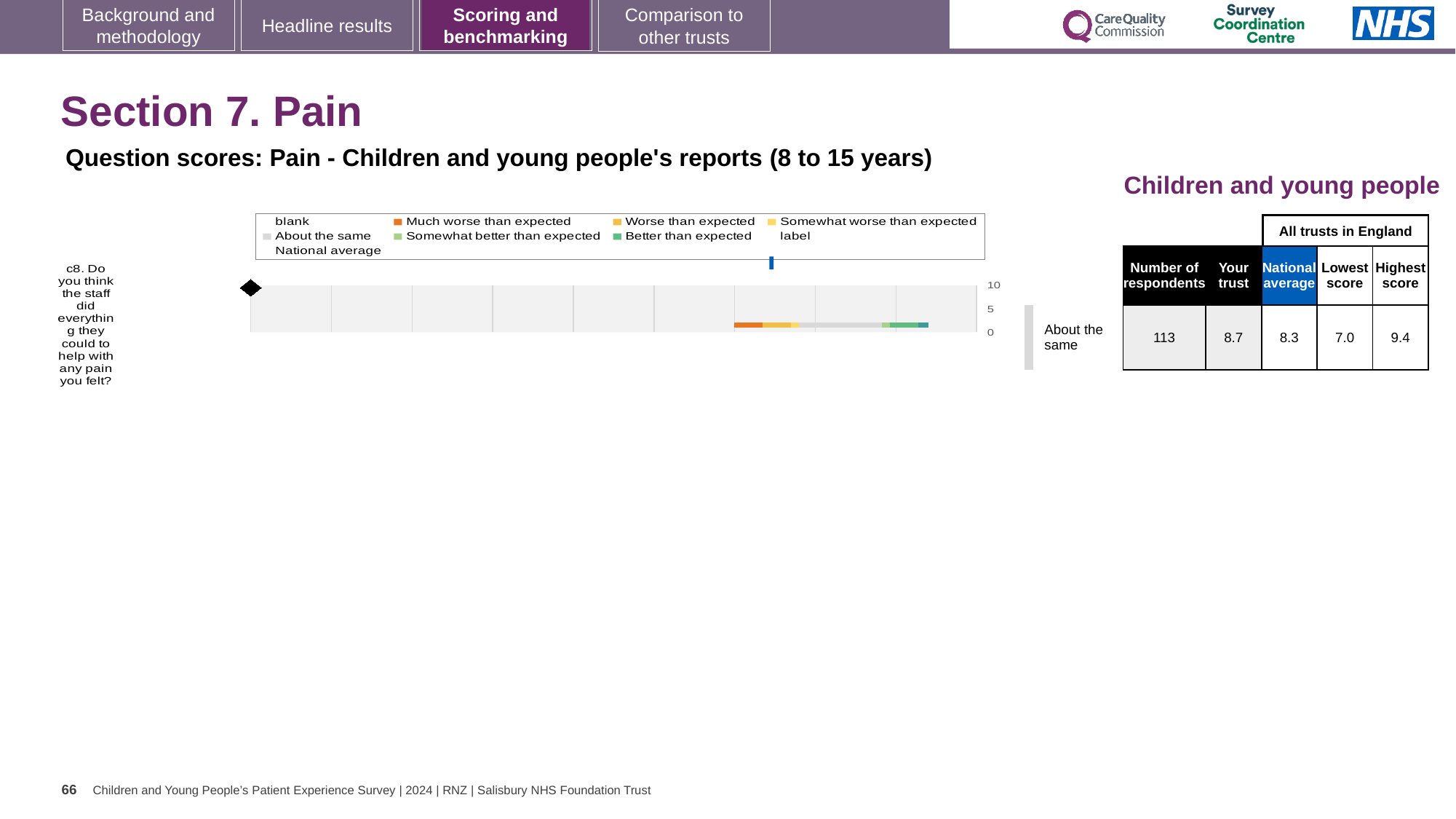
Which is larger for question c8: the Your trust score or the National average score? Your trust What is the difference between the Your trust score and the National average score for question c8? 0.4 In the table beside the chart, what is the Number of respondents for question c8? 113 In the table beside the chart, what is the Your trust score for question c8? 8.7 What is the question number of the category plotted in the chart? c8 In the table beside the chart, what is the Highest score among all trusts in England for question c8? 9.4 In the table beside the chart, what is the Lowest score among all trusts in England for question c8? 7.0 What is the highest value shown on the chart's axis? 10 What kind of chart is shown on the slide? bar chart What benchmark rating is shown next to the chart for question c8? About the same How many question categories are plotted in the chart? 1 In the table beside the chart, what is the National average score for question c8? 8.3